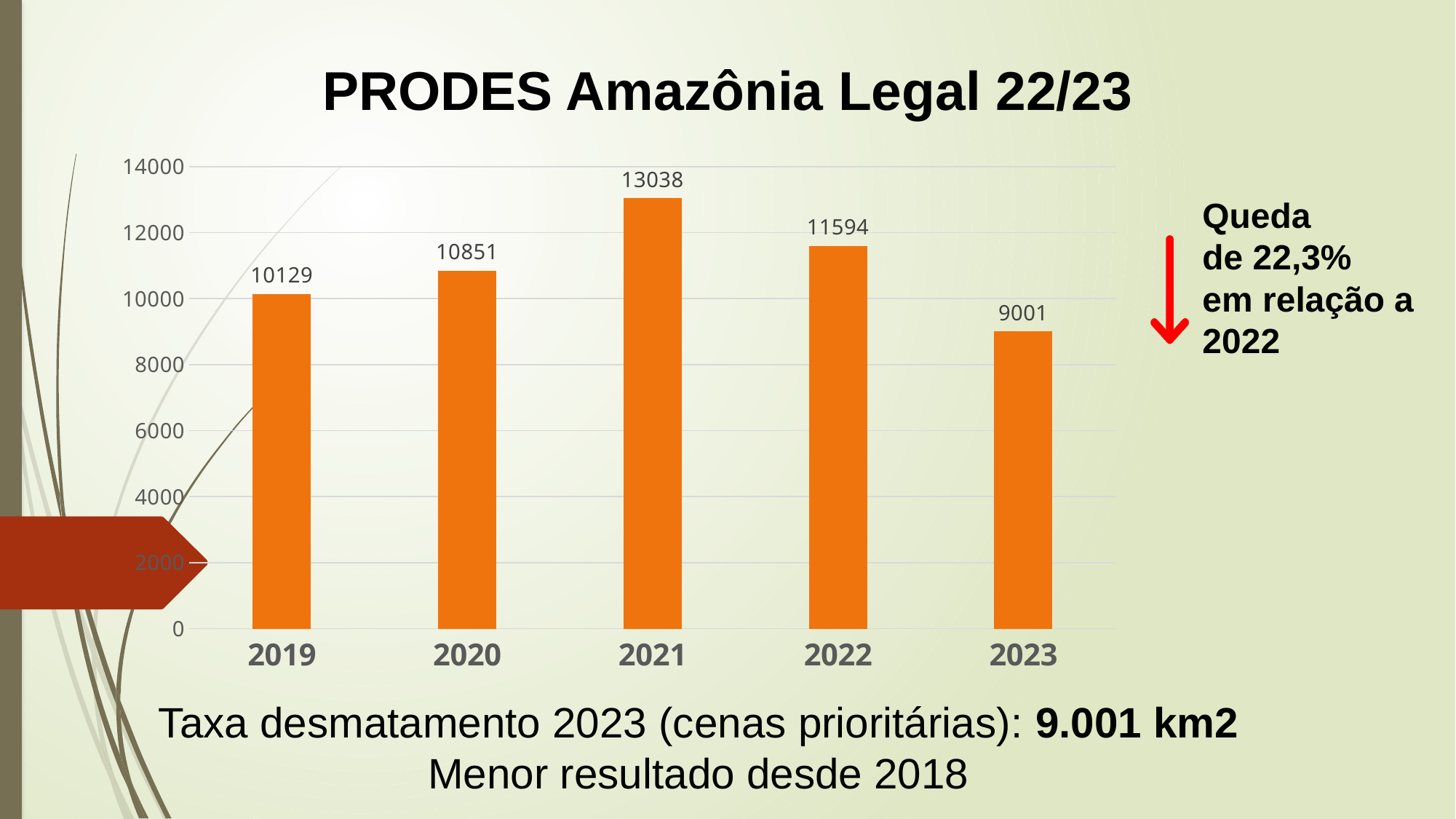
What is the value for 2019? 10129 What is the difference between the values for 2022 and 2023? 2593 Which year has the highest value? 2021 What is the title of the slide containing the chart? PRODES Amazônia Legal 22/23 What is the value for 2023? 9001 What kind of chart is shown on the slide? bar chart What is the difference between the values for 2021 and 2020? 2187 Which is larger, the value for 2020 or the value for 2022? 2022 Is the value for 2021 greater or less than 12000? greater What is the value for 2021? 13038 Which year has the lowest value? 2023 How many years are shown on the x axis? 5